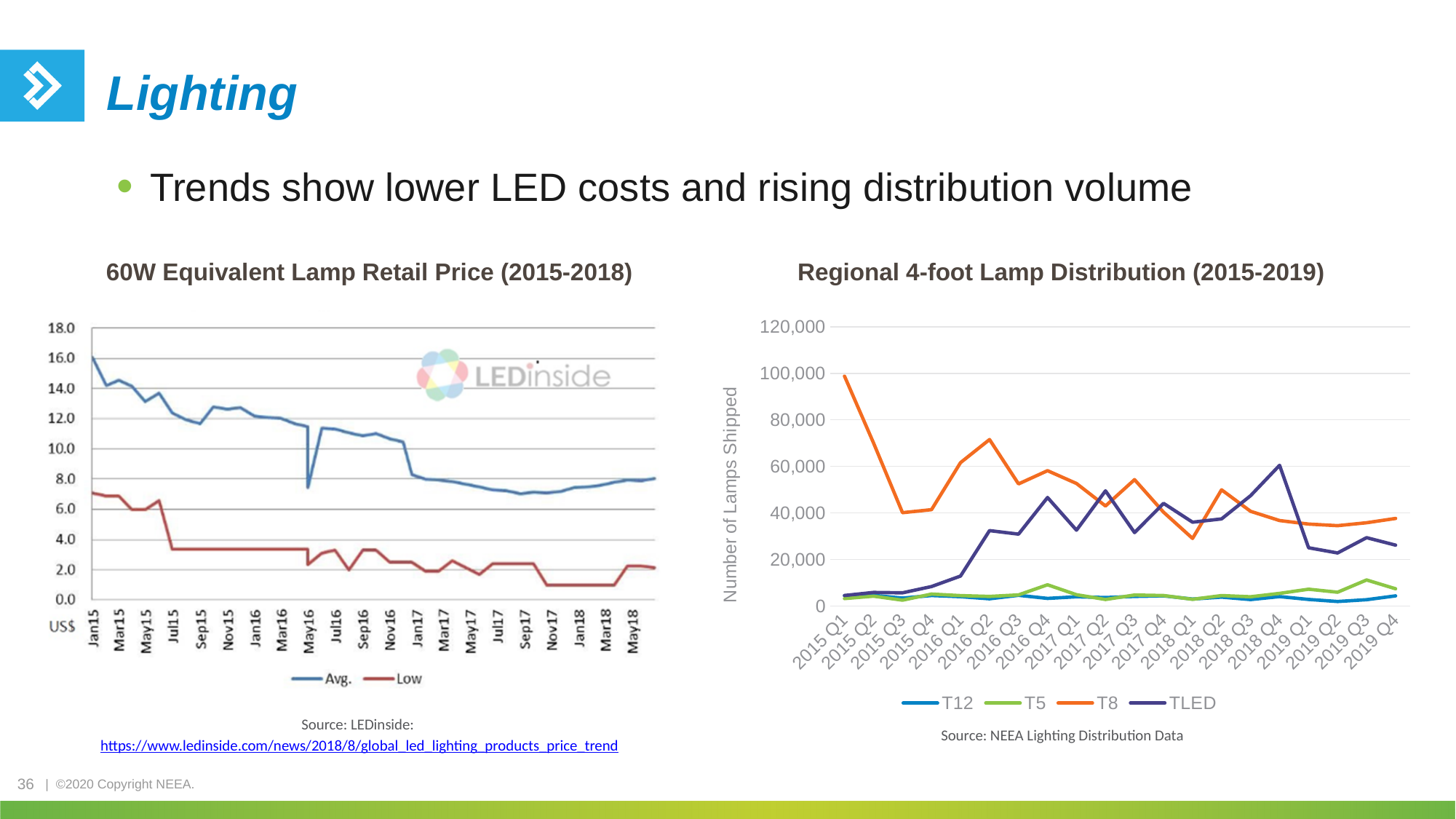
What kind of chart is the 'Regional 4-foot Lamp Distribution (2015-2019)' chart? line chart In the 'Regional 4-foot Lamp Distribution (2015-2019)' chart, is the value for TLED at 2018 Q4 greater or less than 40,000? greater How many series does the legend of the '60W Equivalent Lamp Retail Price (2015-2018)' chart list? 2 In the 'Regional 4-foot Lamp Distribution (2015-2019)' chart, is the value for T8 at 2015 Q1 greater or less than 80,000? greater In the '60W Equivalent Lamp Retail Price (2015-2018)' chart, is the Avg. value at Jan15 greater or less than 14.0? greater In the 'Regional 4-foot Lamp Distribution (2015-2019)' chart, which is larger at 2019 Q4, T8 or TLED? T8 In the '60W Equivalent Lamp Retail Price (2015-2018)' chart, what unit is shown on the y axis? US$ In the 'Regional 4-foot Lamp Distribution (2015-2019)' chart, does the TLED series generally rise or fall from 2015 Q1 to 2018 Q4? rise In the '60W Equivalent Lamp Retail Price (2015-2018)' chart, does the Avg. line generally rise or fall from Jan15 to May18? fall In the 'Regional 4-foot Lamp Distribution (2015-2019)' chart, how many quarters are shown on the x axis? 20 How many series does the legend of the 'Regional 4-foot Lamp Distribution (2015-2019)' chart list? 4 In the 'Regional 4-foot Lamp Distribution (2015-2019)' chart, which series has the highest value at 2015 Q1? T8